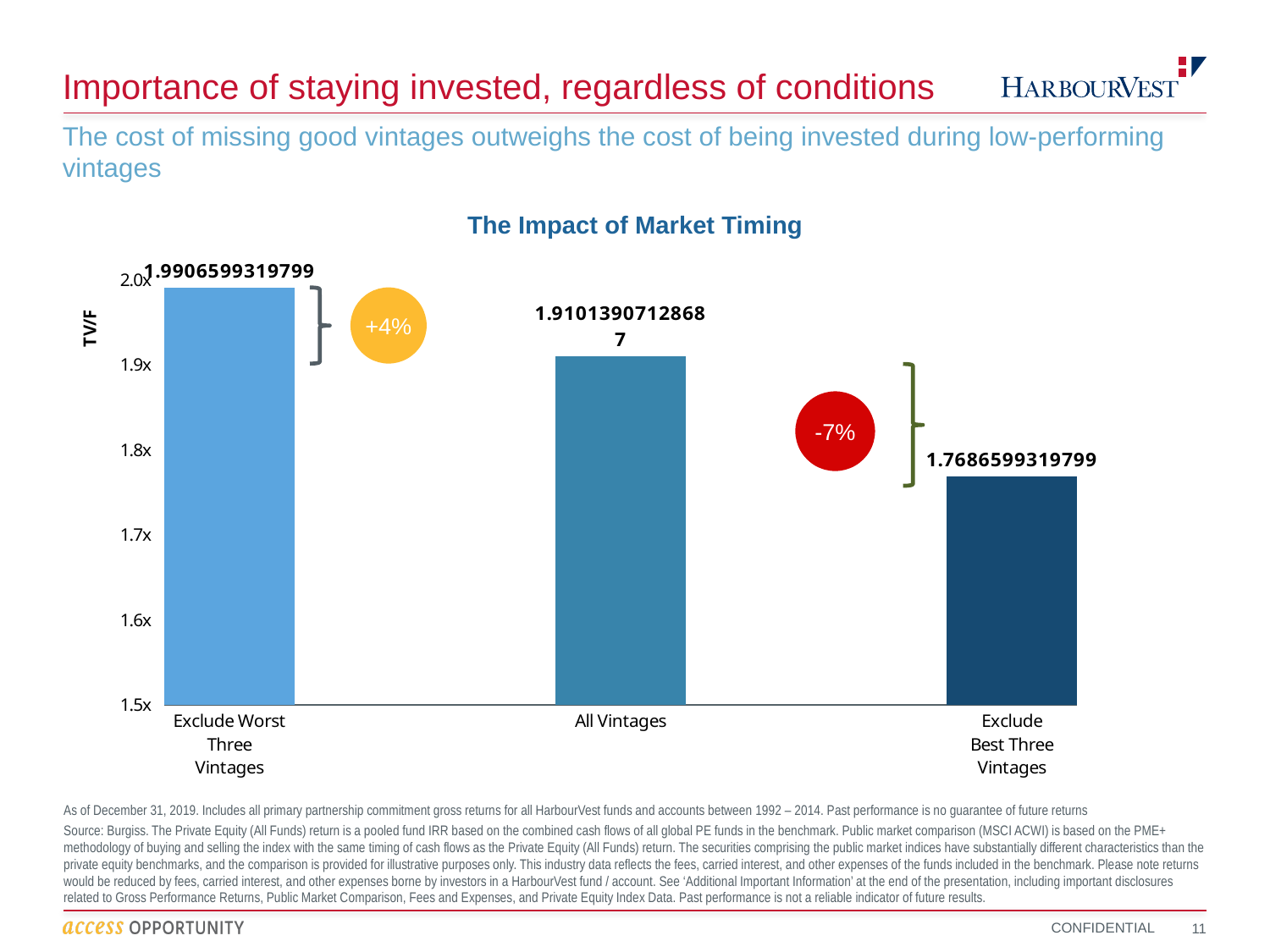
What kind of chart is shown on the slide? Bar chart Is the value for Exclude Worst Three Vintages greater or less than 1.9x? greater Is the value for Exclude Best Three Vintages greater or less than 1.8x? less Which is larger, the value for All Vintages or the value for Exclude Best Three Vintages? All Vintages What is the value for Exclude Worst Three Vintages? 1.9906599319799 What is the title of the chart? The Impact of Market Timing What is the value for Exclude Best Three Vintages? 1.7686599319799 What is the value for All Vintages? 1.91013907128687 Which category has the lowest value? Exclude Best Three Vintages Which category has the highest value? Exclude Worst Three Vintages What is the difference between the values for Exclude Worst Three Vintages and Exclude Best Three Vintages? 0.222 How many categories are shown in the chart? 3